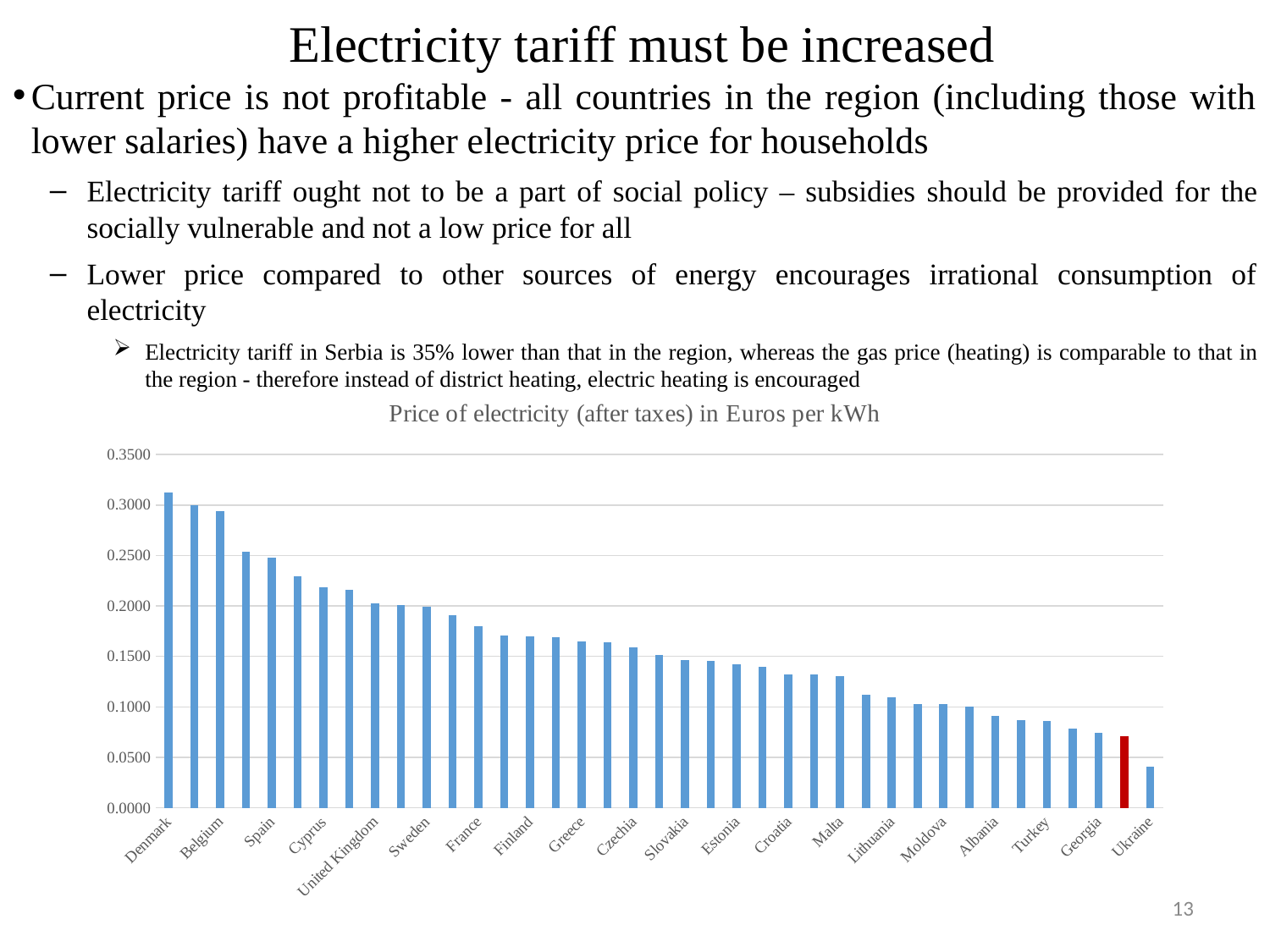
Do the values rise or fall moving from left to right along the x axis? Fall Which country has the highest electricity price in the chart? Denmark Is the value for Denmark greater or less than 0.3000? greater Which has a higher electricity price, Spain or Greece? Spain Which labelled country has the lowest electricity price in the chart? Ukraine Is the value for Ukraine greater or less than 0.0500? less Is the value for France greater or less than 0.2000? less Which has a higher electricity price, Turkey or Lithuania? Lithuania What kind of chart is shown on the slide? Bar chart What is the title of the chart? Price of electricity (after taxes) in Euros per kWh